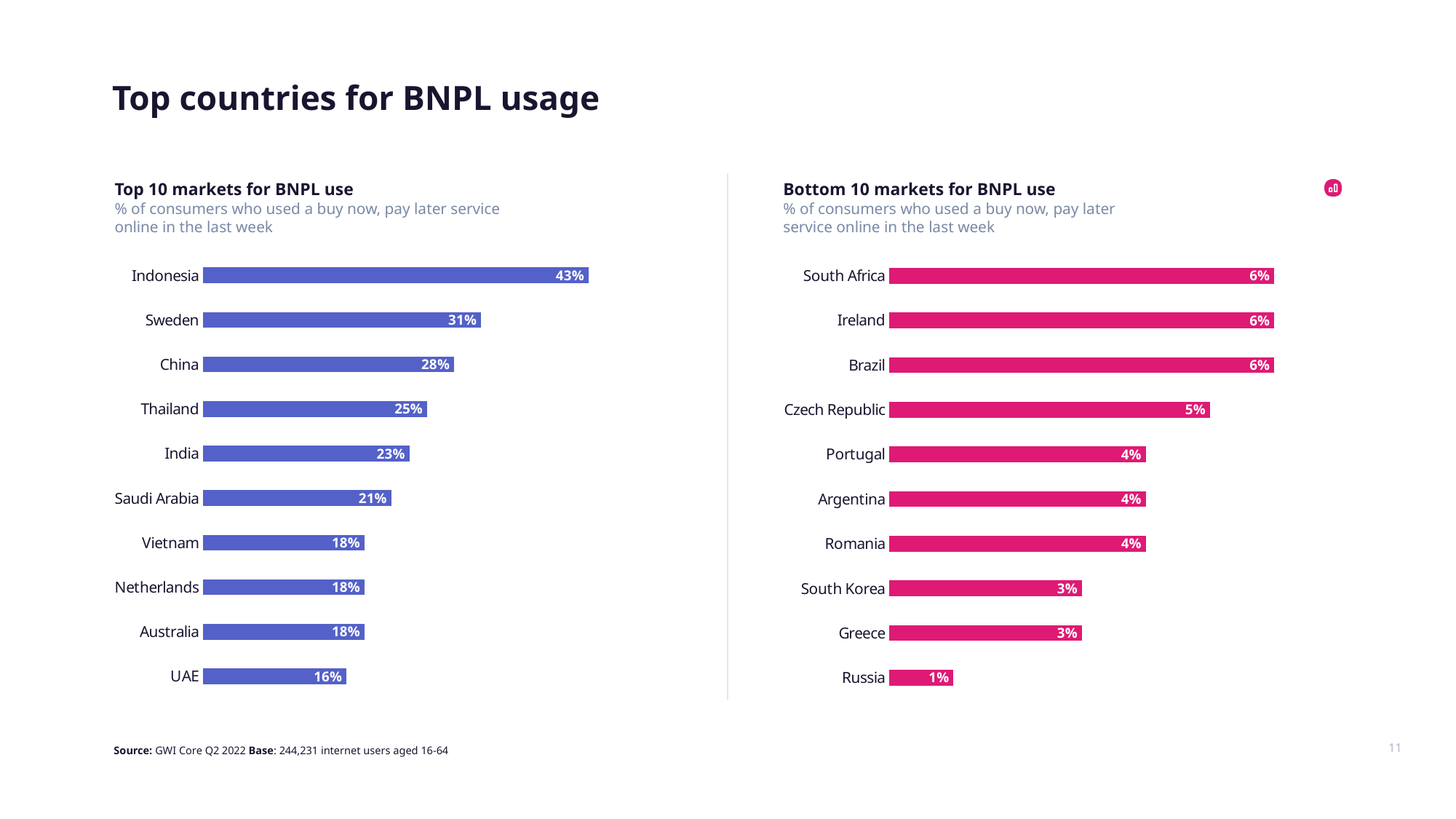
In the 'Top 10 markets for BNPL use' chart, which is larger, China or India? China What type of chart is the 'Top 10 markets for BNPL use' chart? Bar chart How many countries are shown in the 'Bottom 10 markets for BNPL use' chart? 10 In the 'Top 10 markets for BNPL use' chart, what is the value for Thailand? 25% What colour are the bars in the 'Bottom 10 markets for BNPL use' chart? Pink In the 'Top 10 markets for BNPL use' chart, what is the value for Indonesia? 43% In the 'Bottom 10 markets for BNPL use' chart, what is the difference between South Africa and Russia? 5% In the 'Top 10 markets for BNPL use' chart, which country has the highest value? Indonesia In the 'Bottom 10 markets for BNPL use' chart, what is the value for Czech Republic? 5% In the 'Top 10 markets for BNPL use' chart, what is the value for UAE? 16% In the 'Bottom 10 markets for BNPL use' chart, which country has the lowest value? Russia In the 'Top 10 markets for BNPL use' chart, what is the difference between Indonesia and Sweden? 12%